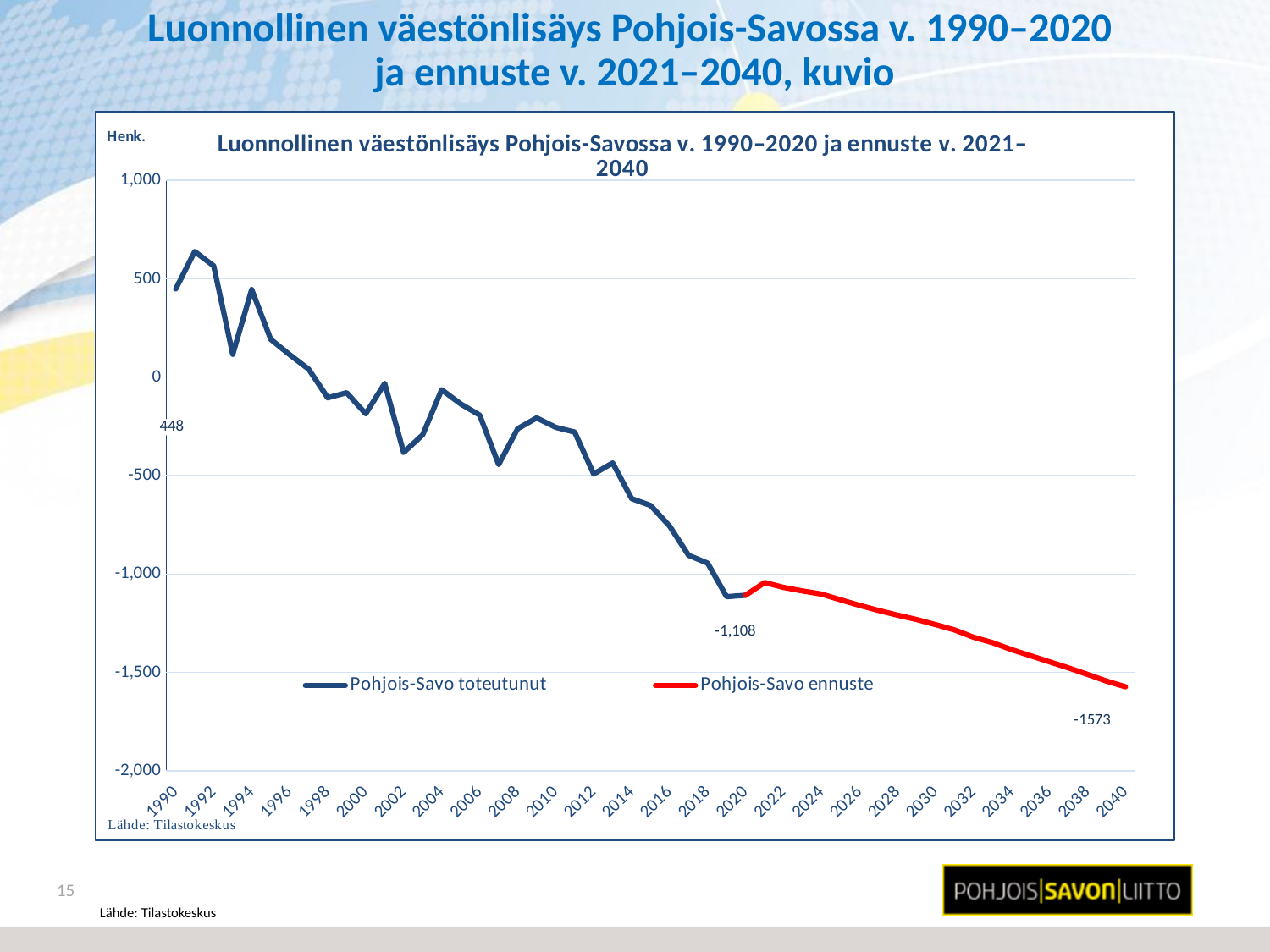
What kind of chart is shown on the slide? line chart What is the value for 1990 in the chart? 448 Which year has the lowest value in the chart? 2040 What is the forecast value for 2040 in the chart? -1573 Do the values generally rise or fall from 1990 to 2040? fall What is the value for 2020 in the chart? -1,108 What is the difference between the 1990 value (448) and the 2020 value (-1,108)? 1,556 How many series does the legend list? 2 Is the value for 2010 greater or less than -500? greater What colour is the line for the series 'Pohjois-Savo ennuste'? red Which is larger, the value for 1990 or the value for 2040? 1990 Is the value for 2030 greater or less than -1,000? less